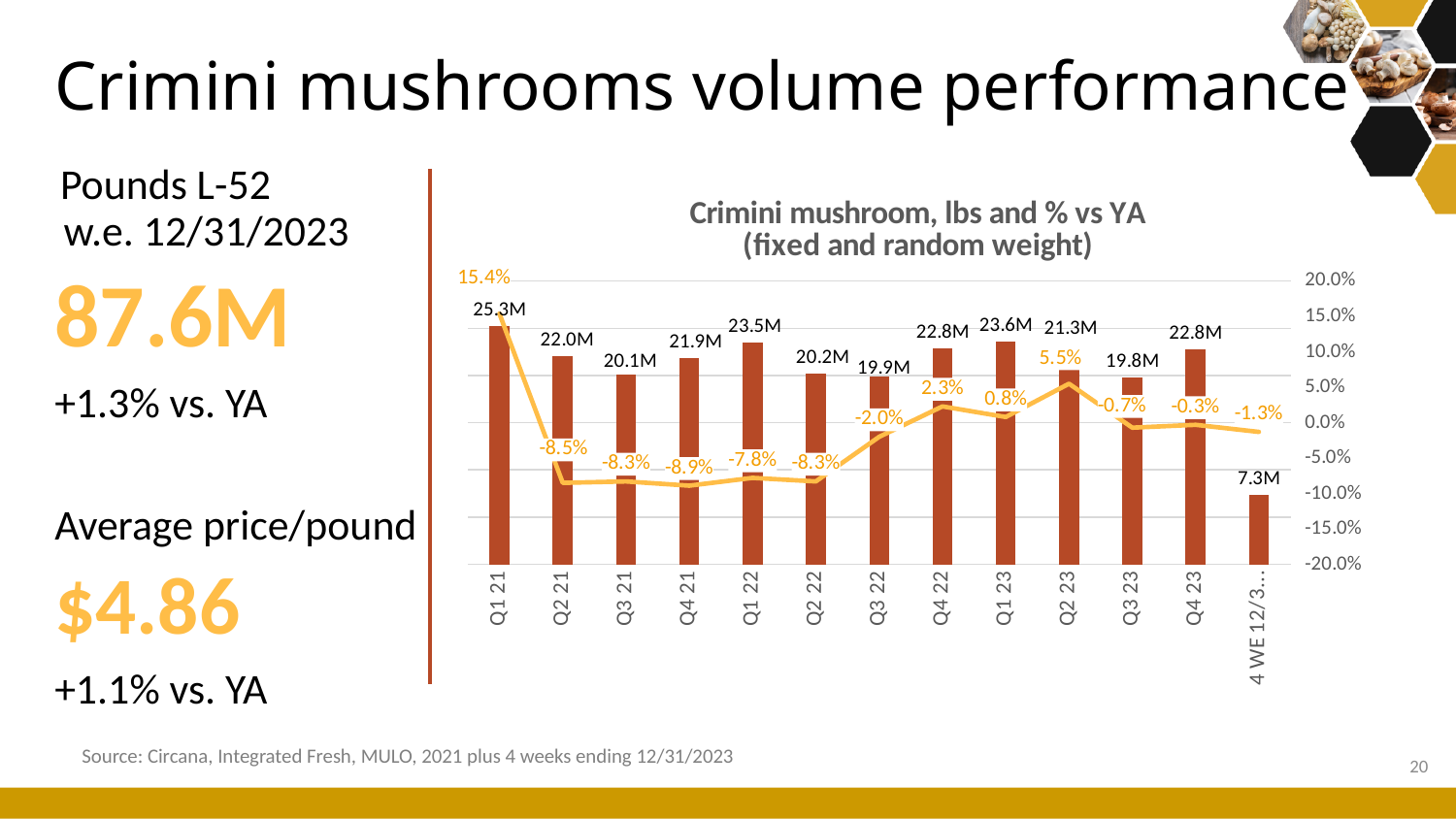
What kind of chart is this? Bar chart with a line Which has the larger volume, Q4 22 or Q2 22? Q4 22 What is the % vs YA value for Q2 23? 5.5% What is the volume in pounds for Q1 21? 25.3M Does the % vs YA line rise or fall from Q1 21 to Q2 21? Fall What is the volume in pounds for Q4 23? 22.8M How many categories are shown on the x axis? 13 What is the difference in pounds between Q1 23 and Q3 23? 3.8M Which quarter has the highest volume bar? Q1 21 By how many percentage points does the % vs YA value for Q2 23 exceed that of Q1 23? 4.7 percentage points What is the title of the chart? Crimini mushroom, lbs and % vs YA (fixed and random weight) What is the % vs YA value for Q3 22? -2.0%